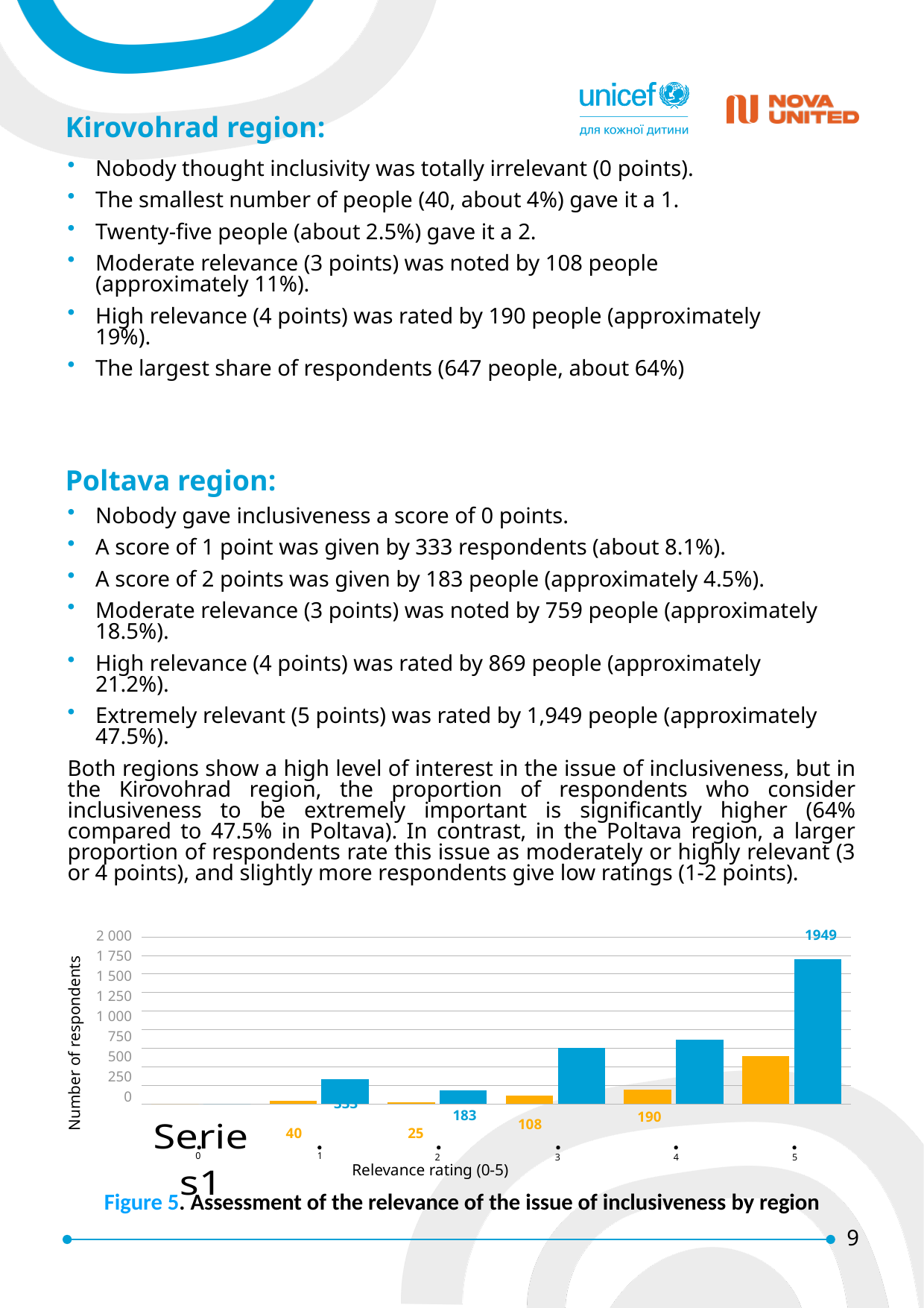
What is the value of the orange bar at relevance rating 3? 108 What type of chart is shown in Figure 5? bar chart What is the title of the y axis of the chart? Number of respondents At which relevance rating is the blue bar the tallest? 5 How many relevance rating categories are shown on the x axis? 6 Is the value of the blue bar at relevance rating 3 greater or less than 250? greater What is the difference between the orange bar values at ratings 4 and 3? 82 What is the value of the blue bar at relevance rating 2? 183 What is the value of the blue bar at relevance rating 5? 1949 What is the value of the orange bar at relevance rating 2? 25 What is the value of the orange bar at relevance rating 1? 40 At relevance rating 3, which bar is taller, the orange or the blue one? blue